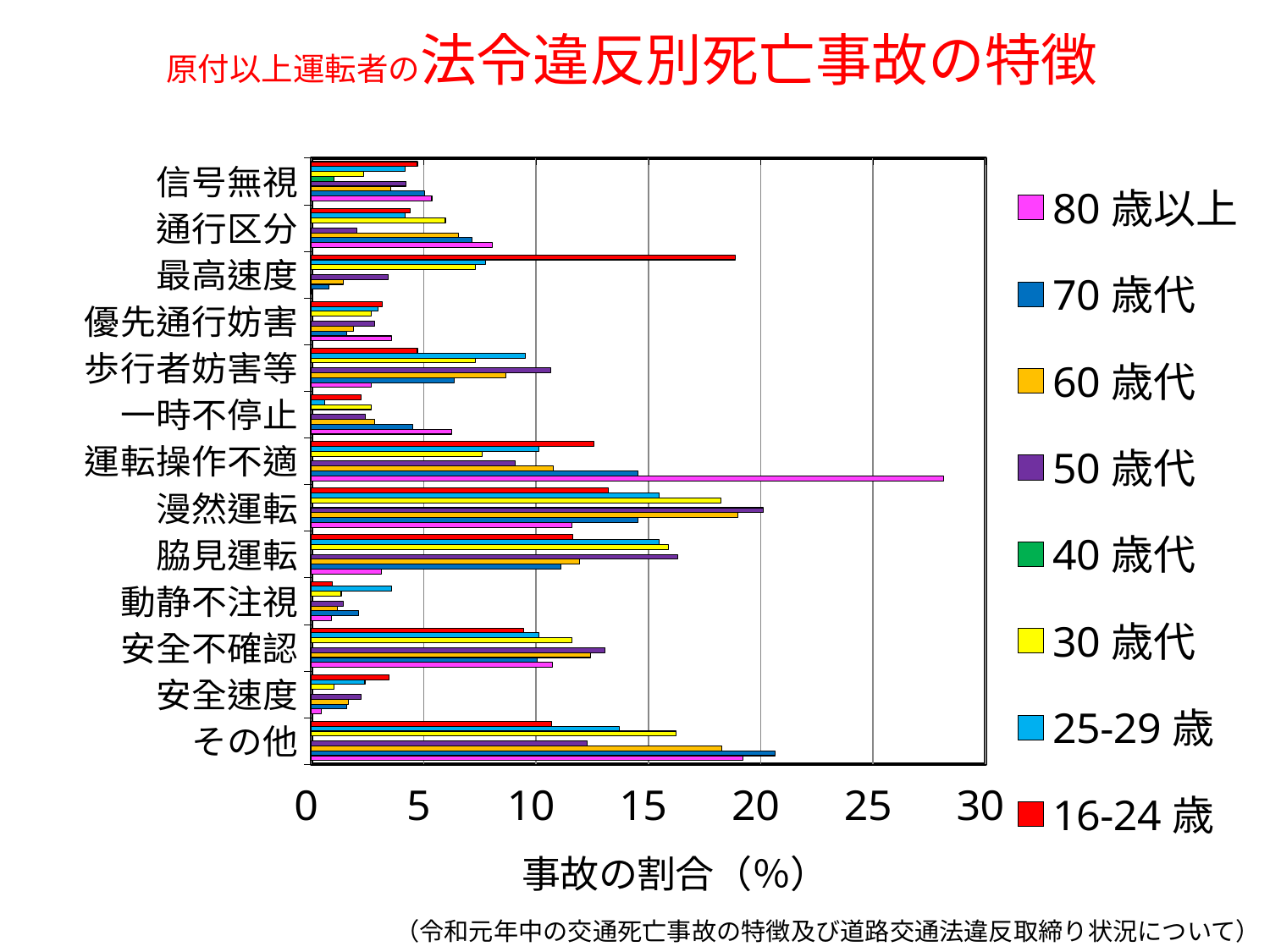
In 最高速度, which is larger: the value for 16-24 歳 or the value for 80 歳以上? 16-24 歳 How many violation categories are listed on the vertical axis of the chart? 13 Is the value for 80 歳以上 in 運転操作不適 greater or less than 25? greater What is the title of the horizontal axis? 事故の割合（%） What kind of chart is shown on the slide? bar chart How many age-group series does the legend list? 8 Which category has the longest bar for the 16-24 歳 series? 最高速度 Which category has the longest bar for the 80 歳以上 series? 運転操作不適 Which legend entry is shown in red? 16-24 歳 In 運転操作不適, which is larger: the value for 80 歳以上 or the value for 16-24 歳? 80 歳以上 Is the value for 80 歳以上 in 安全速度 greater or less than 5? less Is the value for 16-24 歳 in 最高速度 greater or less than 15? greater